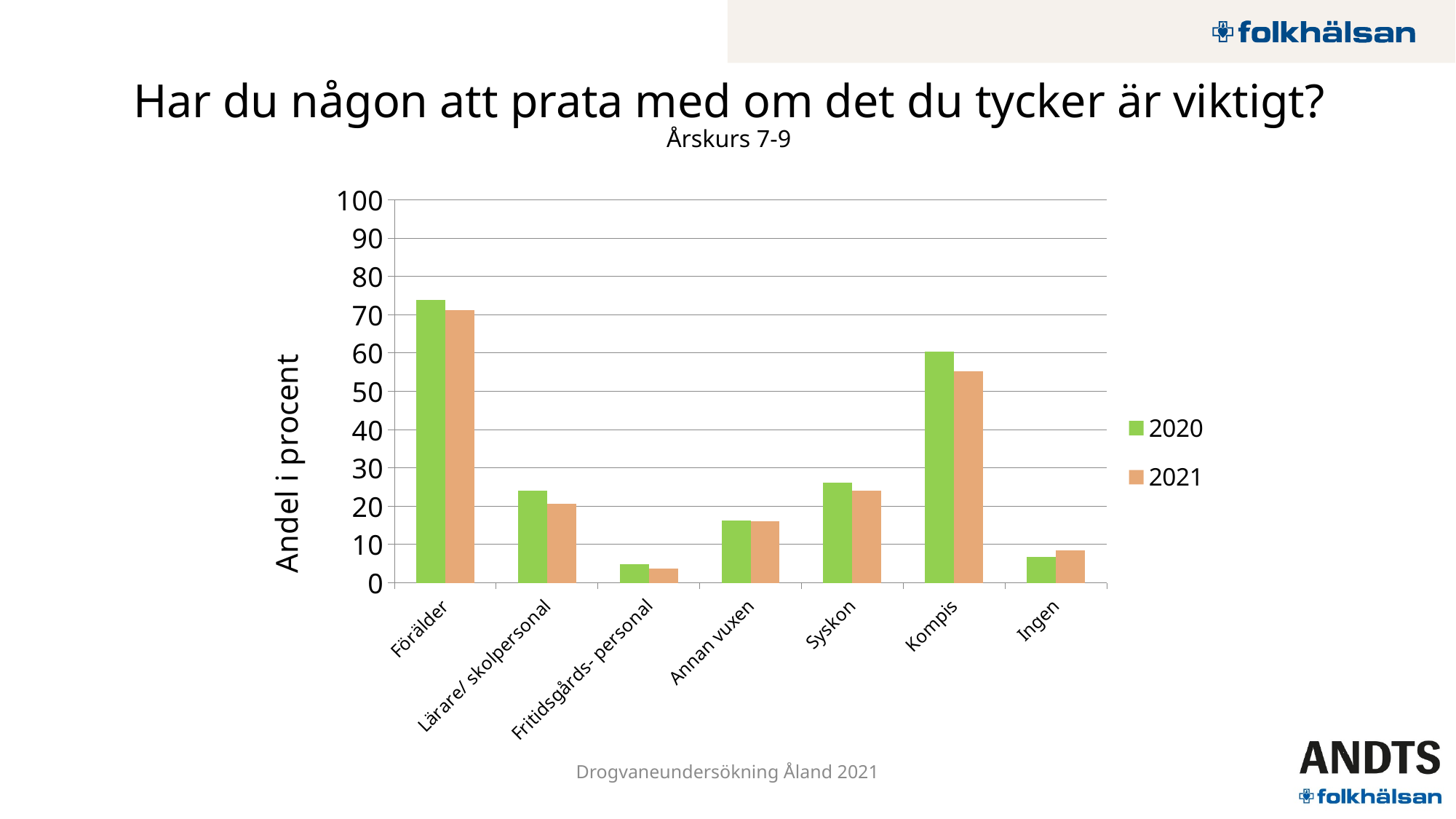
Is the value for Förälder in 2020 greater or less than 70? greater Is the value for Ingen in 2021 greater or less than 10? less For Kompis, which year has the larger value, 2020 or 2021? 2020 How many categories are shown on the x axis? 7 Which category has the lowest value for 2021? Fritidsgårds- personal What kind of chart is shown on the slide? bar chart Which category has the highest value for 2020? Förälder Is the value for Kompis in 2021 greater or less than 50? greater How many series does the legend list? 2 What is the label on the y axis? Andel i procent For Ingen, which year has the larger value, 2020 or 2021? 2021